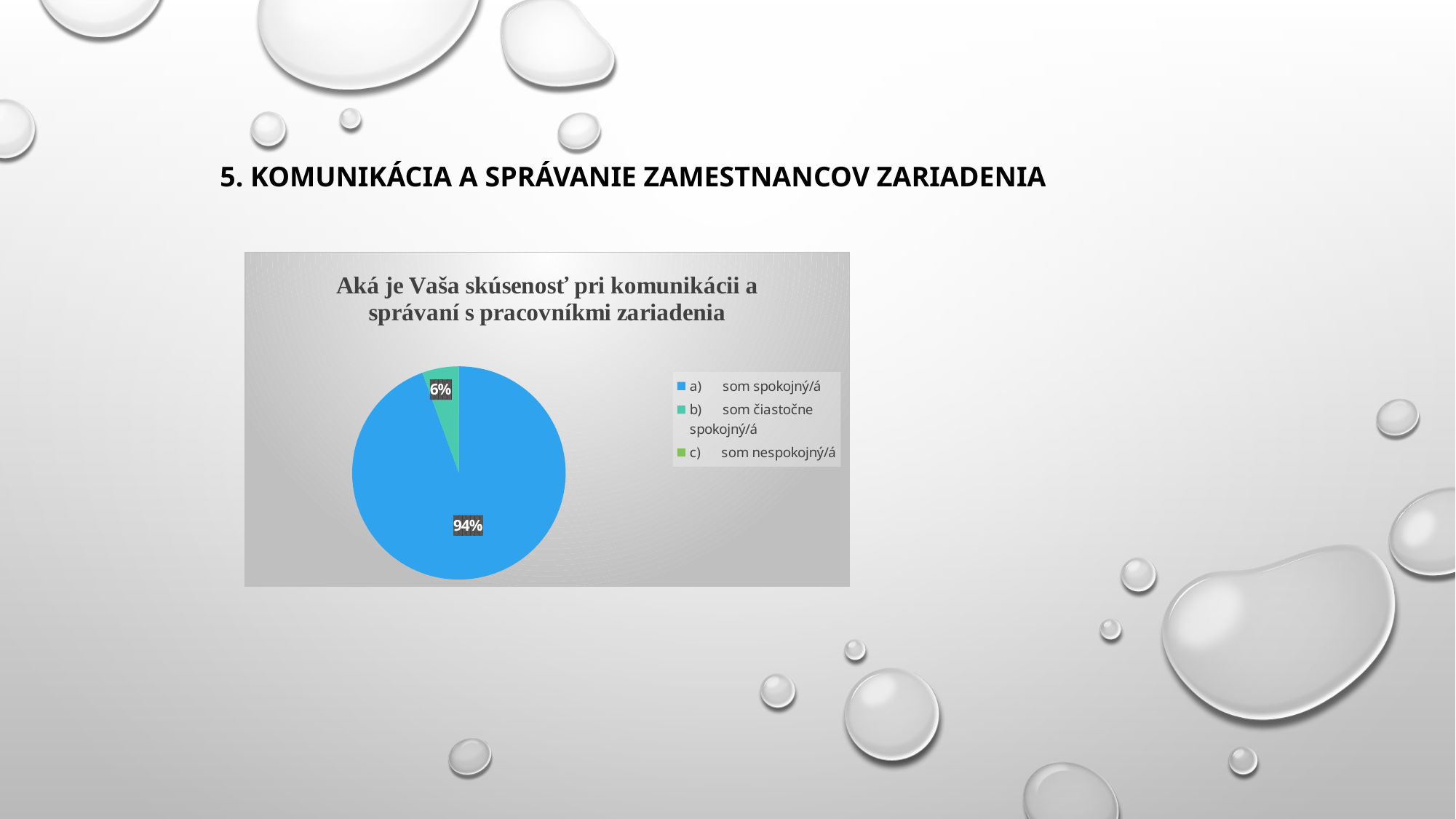
Which category has the largest slice of the pie? a) som spokojný/á What is the title of the chart? Aká je Vaša skúsenosť pri komunikácii a správaní s pracovníkmi zariadenia How many entries does the legend list? 3 What share of the pie does "a) som spokojný/á" have? 94% Which of the two labelled slices is larger, "a) som spokojný/á" or "b) som čiastočne spokojný/á"? a) som spokojný/á What share of the pie does "b) som čiastočne spokojný/á" have? 6% What kind of chart is shown on the slide? pie chart What is the difference in percentage points between the "a) som spokojný/á" slice and the "b) som čiastočne spokojný/á" slice? 88 What colour is the slice for "a) som spokojný/á"? blue Is the share for "a) som spokojný/á" greater or less than 50%? greater